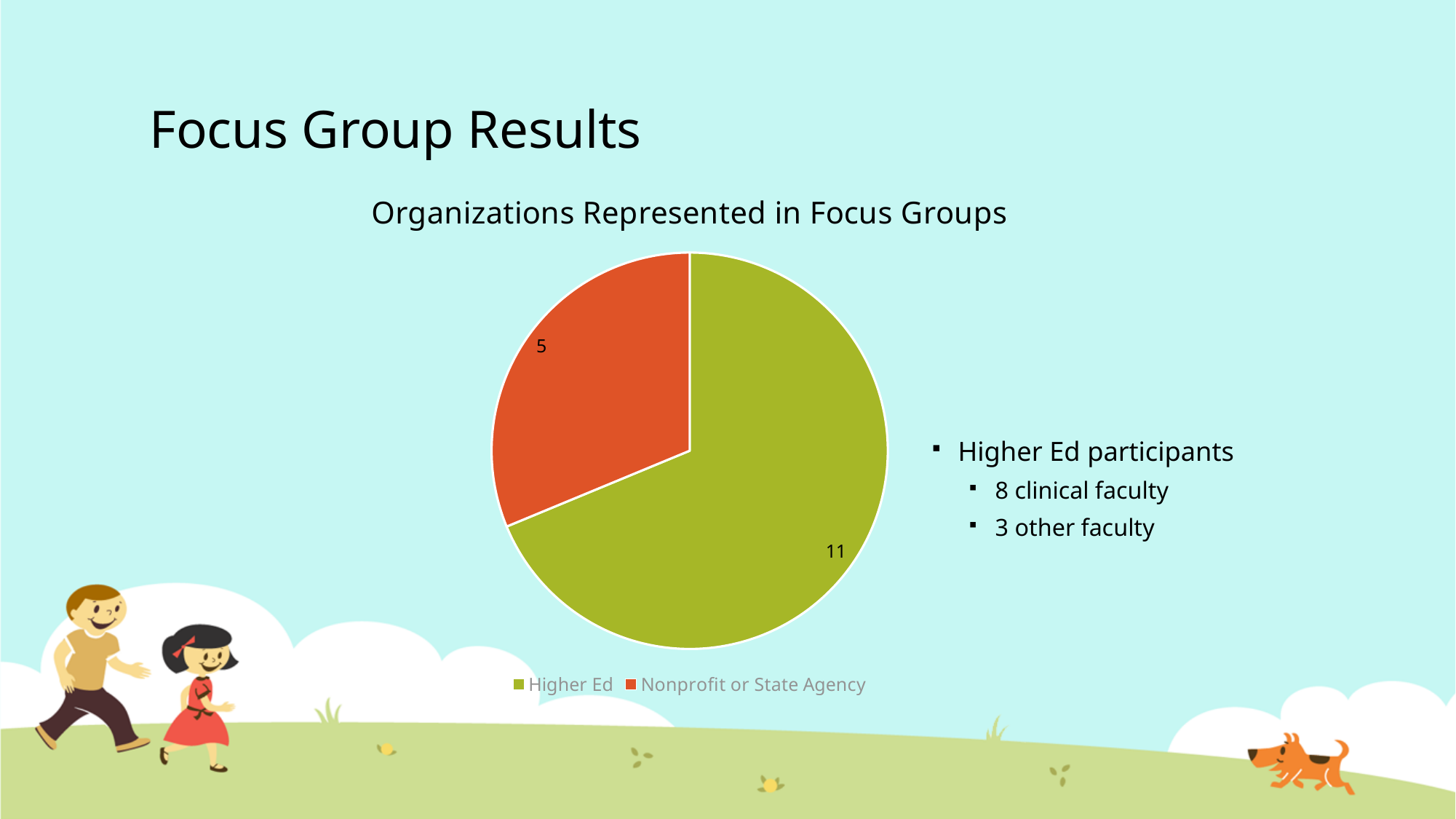
What kind of chart is shown on the slide? pie chart Which category has the largest slice? Higher Ed What share of the pie does Nonprofit or State Agency represent? 5 of 16 Which category has the smallest slice? Nonprofit or State Agency How many categories does the pie chart have? 2 What is the title of the chart? Organizations Represented in Focus Groups What is the value for Higher Ed? 11 What is the value for Nonprofit or State Agency? 5 What is the difference between the Higher Ed value and the Nonprofit or State Agency value? 6 Which is larger, Higher Ed or Nonprofit or State Agency? Higher Ed What is the total of all slices in the pie chart? 16 What colour is the Higher Ed slice? green